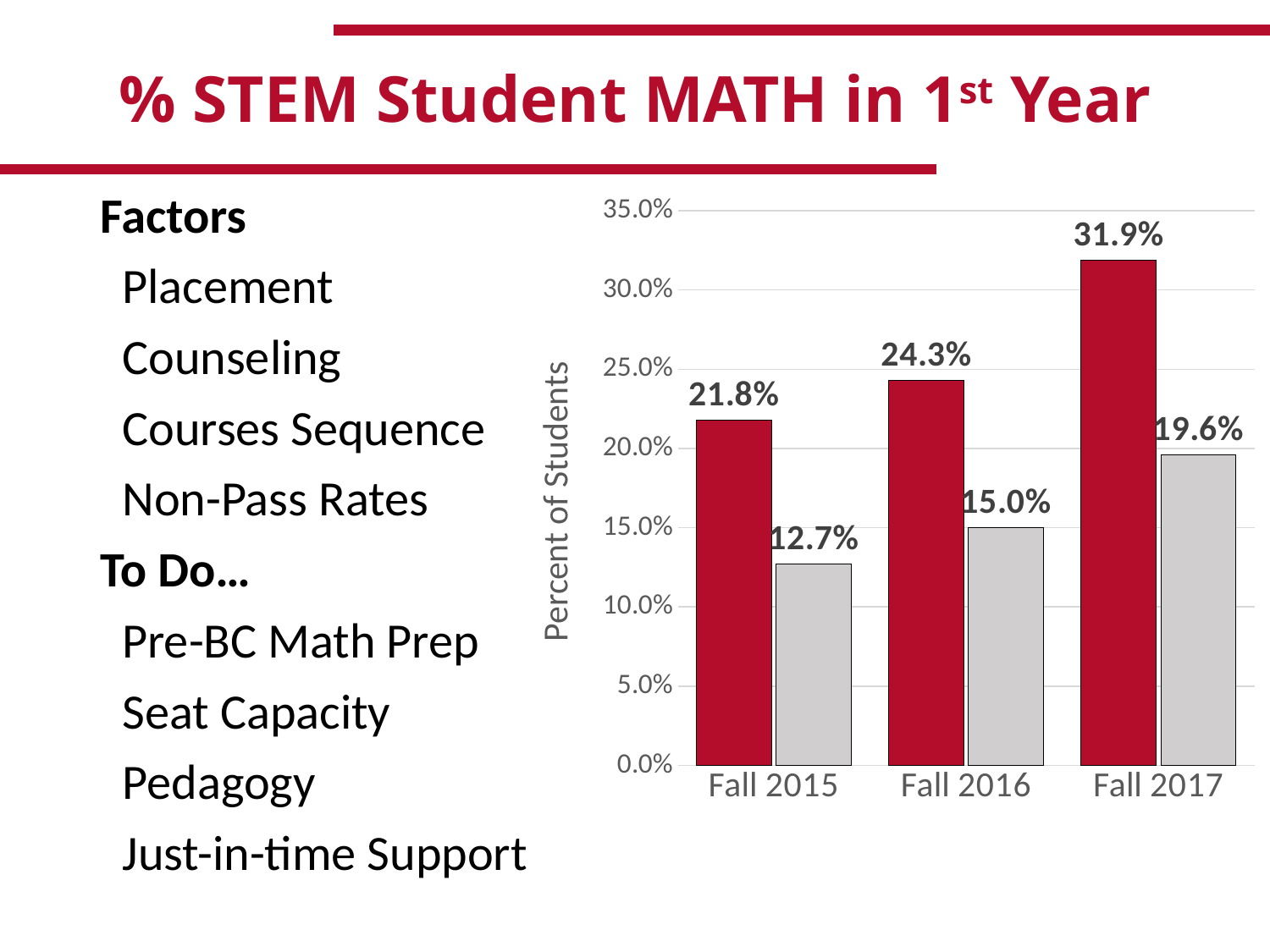
What is the value of the gray bar for Fall 2015? 12.7% Which category has the highest red bar? Fall 2017 Which is larger, the gray bar for Fall 2017 or the red bar for Fall 2015? The red bar for Fall 2015 How many categories are shown on the x axis? 3 What is the difference between the red and gray bars for Fall 2016? 9.3 percentage points What is the value of the red bar for Fall 2017? 31.9% Do the red bar values rise or fall from Fall 2015 to Fall 2017? Rise What kind of chart is shown on the slide? Bar chart What is the value of the red bar for Fall 2016? 24.3% What is the value of the gray bar for Fall 2017? 19.6% What is the difference between the red bar values for Fall 2017 and Fall 2015? 10.1 percentage points Which category has the lowest gray bar? Fall 2015